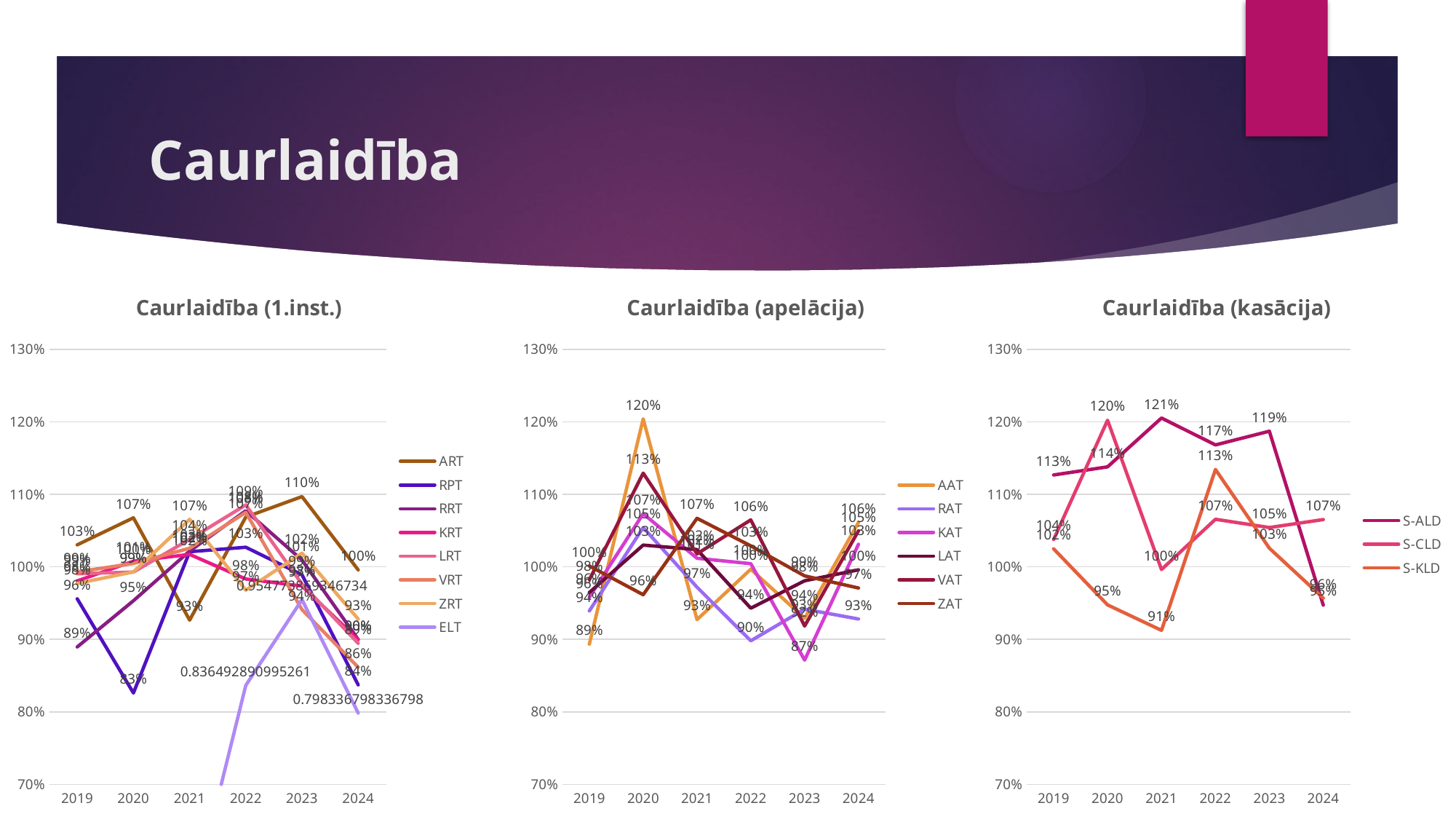
What kind of chart is the Caurlaidība (apelācija) chart? Line chart In the Caurlaidība (1.inst.) chart, what is the value for RPT in 2020? 83% In the Caurlaidība (kasācija) chart, which is larger in 2020, S-ALD or S-CLD? S-CLD How many series does the legend of the Caurlaidība (kasācija) chart list? 3 In the Caurlaidība (kasācija) chart, what is the value for S-CLD in 2020? 120% In the Caurlaidība (kasācija) chart, what is the difference between S-CLD and S-KLD in 2020? 25 percentage points In the Caurlaidība (kasācija) chart, in which year is S-KLD at its lowest? 2021 In the Caurlaidība (apelācija) chart, what is the value for AAT in 2020? 120% In the Caurlaidība (kasācija) chart, what is the value for S-KLD in 2021? 91% In the Caurlaidība (kasācija) chart, what is the value for S-ALD in 2021? 121% In the Caurlaidība (1.inst.) chart, what is the value for ART in 2023? 110% In the Caurlaidība (apelācija) chart, what is the value for KAT in 2023? 87%